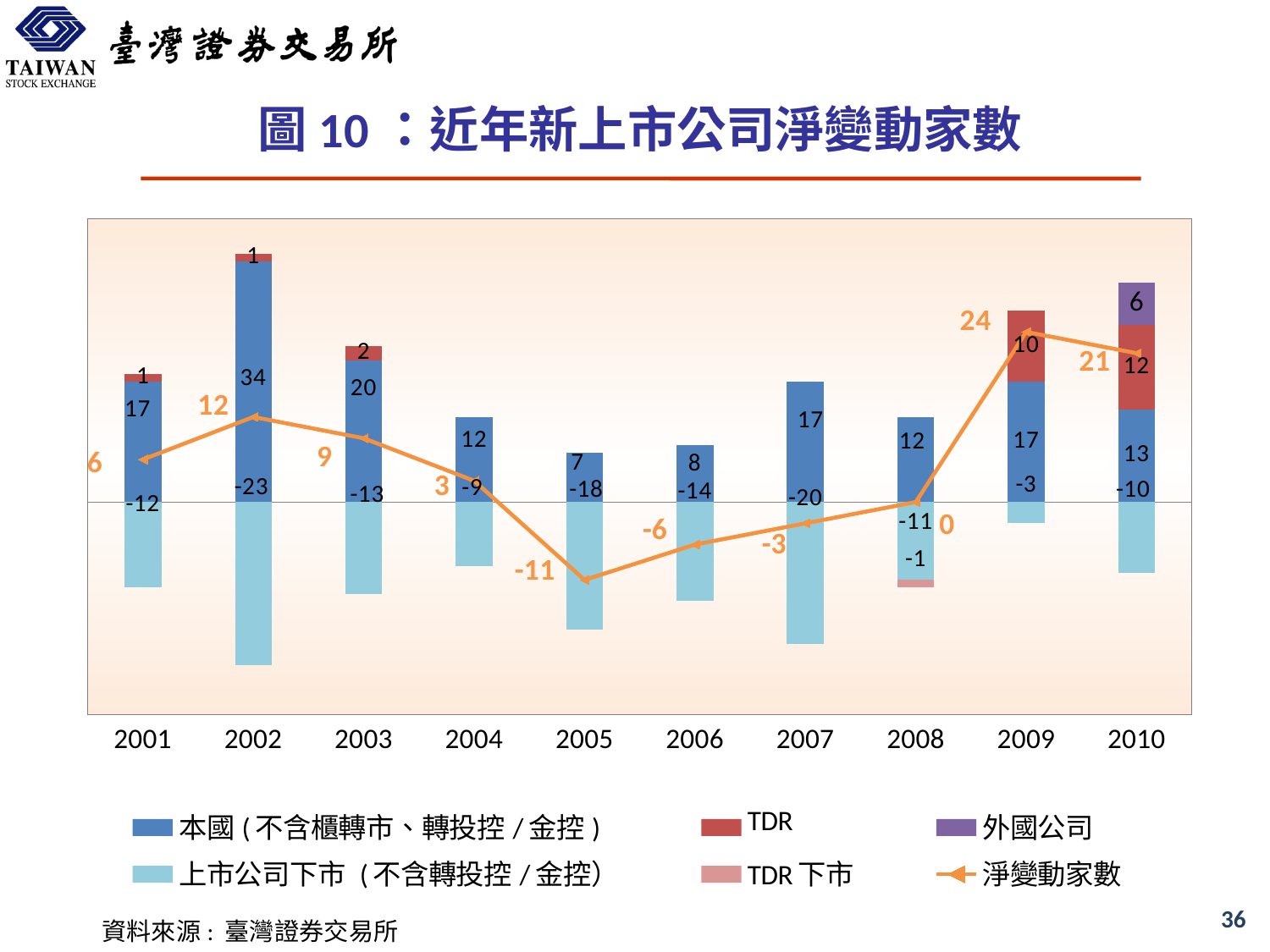
What is the TDR value for 2010? 12 Which year is the only one with a 外國公司 value shown? 2010 What is the 上市公司下市 value for 2007? -20 How many years are shown on the x axis? 10 What is the value of 本國 (不含櫃轉市、轉投控/金控) for 2002? 34 Is the 本國 value larger in 2005 or in 2006? 2006 What is the 淨變動家數 value for 2009? 24 What is the difference between the 本國 values for 2002 and 2003? 14 Which year has the lowest 淨變動家數 value? 2005 What kind of chart is shown on the slide? Stacked bar chart with a line Which year has the highest 淨變動家數 value? 2009 How many series does the legend list? 6